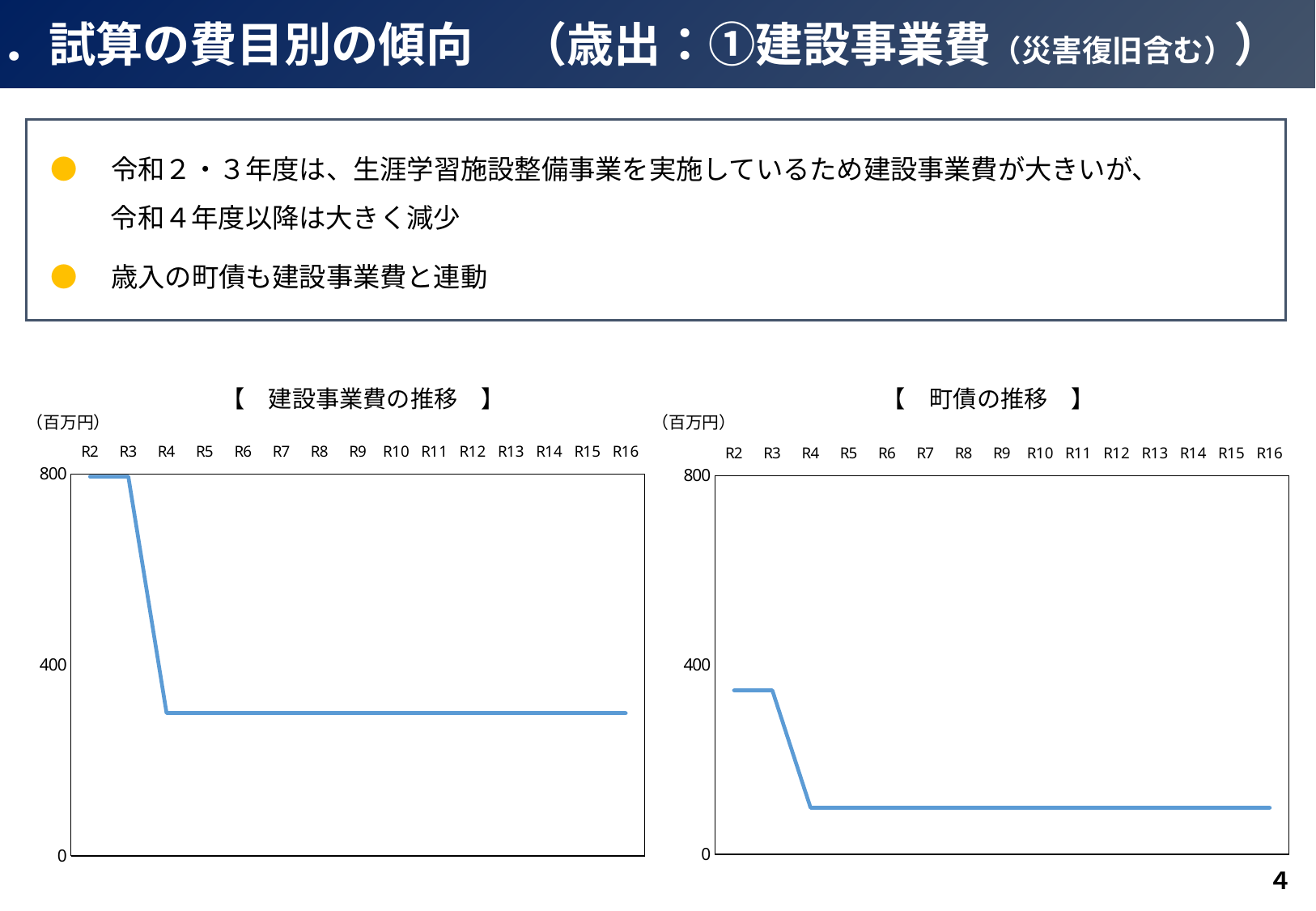
In the 町債の推移 chart, is the value for R2 greater or less than 400? less What kind of chart is the 町債の推移 chart? line chart In the 建設事業費の推移 chart, which is larger, the value for R3 or the value for R4? R3 In the 建設事業費の推移 chart, is the value for R5 greater or less than 400? less In the 建設事業費の推移 chart, do the values rise or fall from R3 to R4? fall In the 建設事業費の推移 chart, is the value for R2 greater or less than 400? greater In the 町債の推移 chart, which is larger, the value for R3 or the value for R4? R3 What unit is shown on the y axis of the 町債の推移 chart? 百万円 How many years are plotted on the x axis of the 町債の推移 chart? 15 How many years are plotted on the x axis of the 建設事業費の推移 chart? 15 What kind of chart is the 建設事業費の推移 chart? line chart